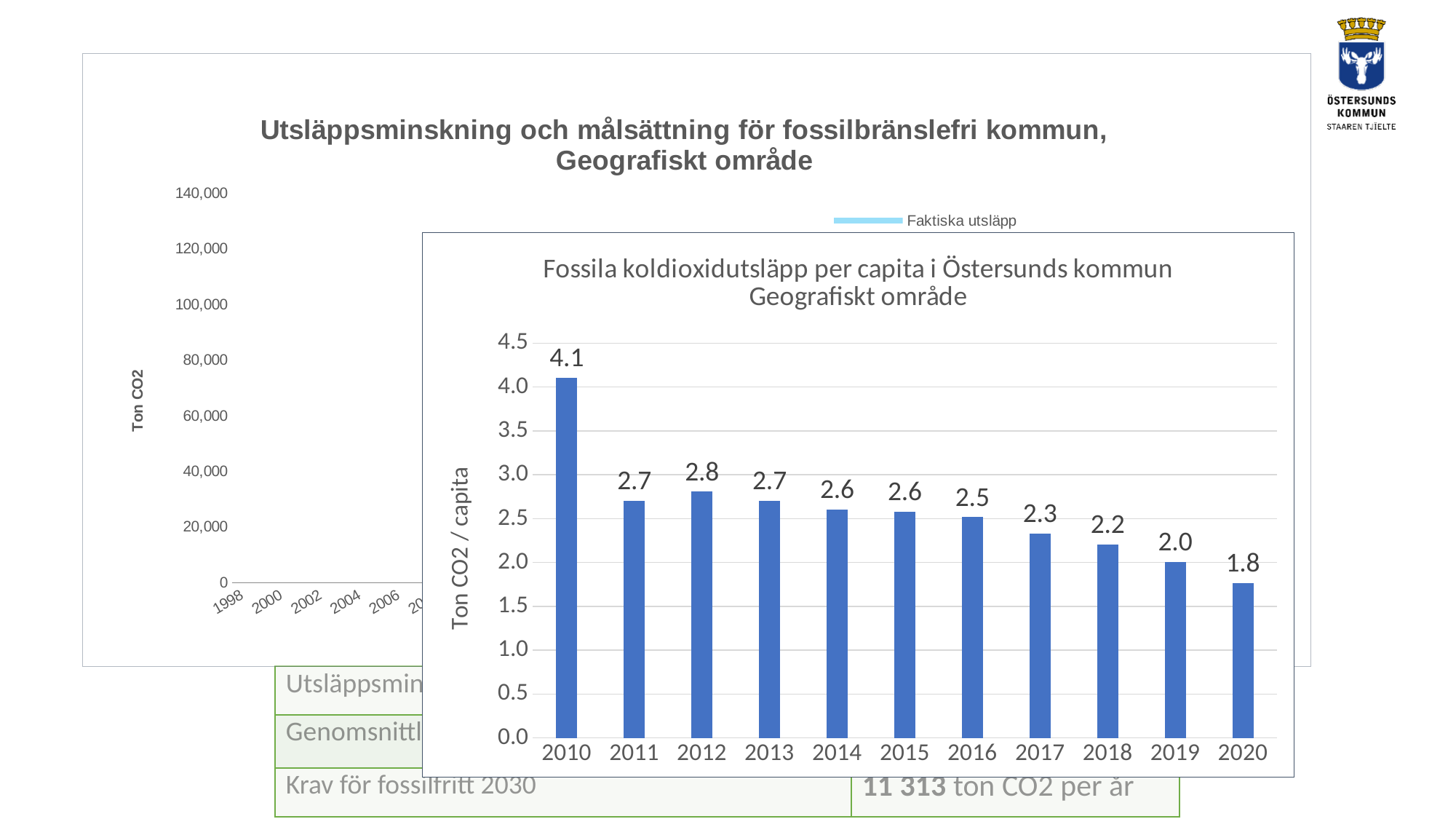
In the chart titled "Fossila koldioxidutsläpp per capita i Östersunds kommun", which year has the lowest value? 2020 In the chart titled "Fossila koldioxidutsläpp per capita i Östersunds kommun", do the values generally rise or fall from 2010 to 2020? fall In the chart titled "Fossila koldioxidutsläpp per capita i Östersunds kommun", which year has the highest value? 2010 In the chart titled "Fossila koldioxidutsläpp per capita i Östersunds kommun", what is the value for 2020? 1.8 In the chart titled "Fossila koldioxidutsläpp per capita i Östersunds kommun", what is the value for 2010? 4.1 In the chart titled "Fossila koldioxidutsläpp per capita i Östersunds kommun", what is the value for 2016? 2.5 In the chart titled "Fossila koldioxidutsläpp per capita i Östersunds kommun", is the value for 2019 greater or less than 2.5? less What is the y-axis label of the chart titled "Fossila koldioxidutsläpp per capita i Östersunds kommun"? Ton CO2 / capita What kind of chart is the one titled "Fossila koldioxidutsläpp per capita i Östersunds kommun"? bar chart In the chart titled "Fossila koldioxidutsläpp per capita i Östersunds kommun", which is larger, the value for 2012 or the value for 2017? 2012 In the chart titled "Fossila koldioxidutsläpp per capita i Östersunds kommun", how many years are shown on the x axis? 11 In the chart titled "Fossila koldioxidutsläpp per capita i Östersunds kommun", what is the difference between the values for 2010 and 2020? 2.3